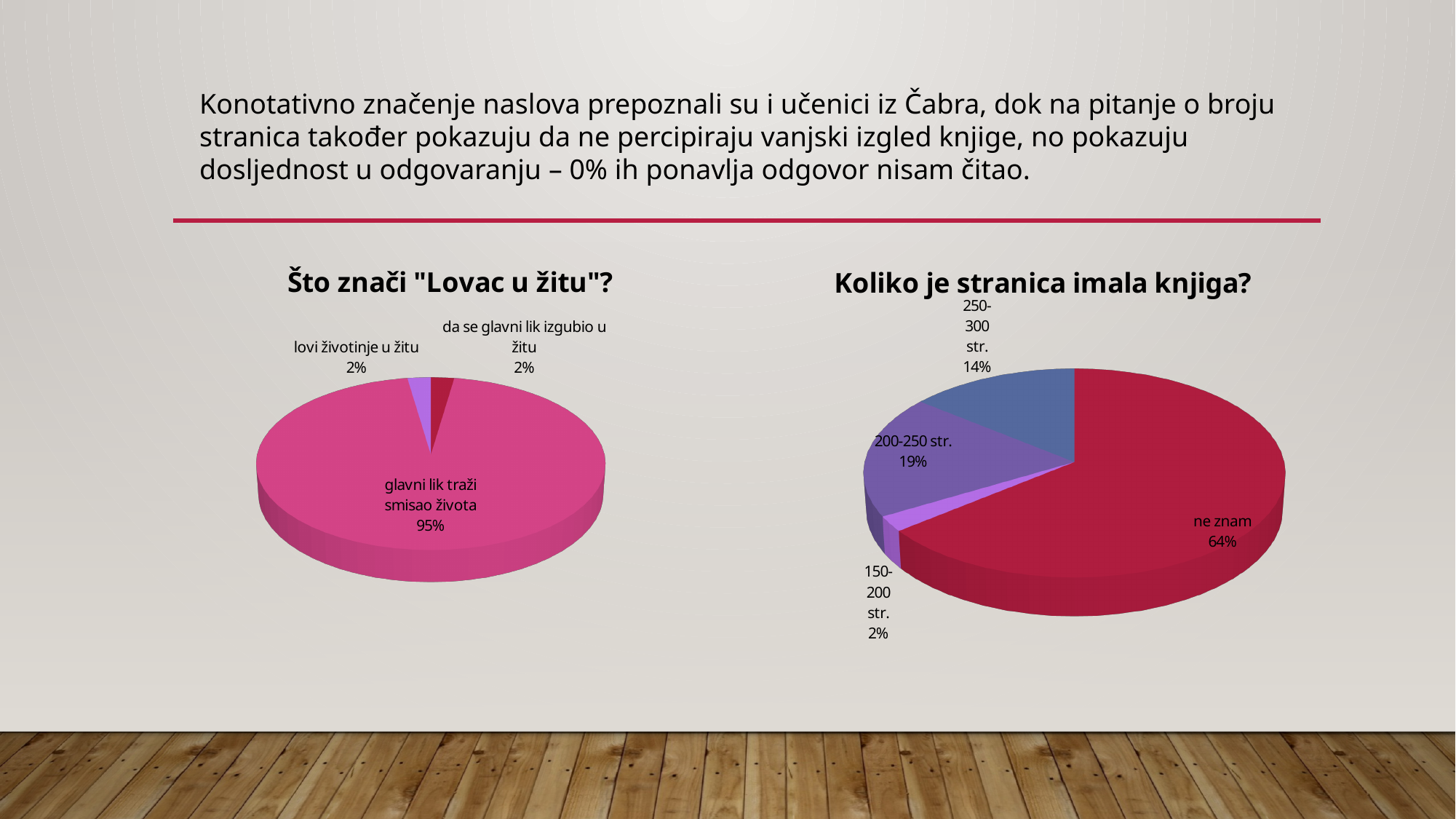
In the chart titled "Koliko je stranica imala knjiga?", what share is labelled for "250-300 str."? 14% In the chart titled "Koliko je stranica imala knjiga?", how many slices does the pie have? 4 In the chart titled "Što znači "Lovac u žitu"?", what share is labelled for "glavni lik traži smisao života"? 95% In the chart titled "Koliko je stranica imala knjiga?", what is the difference between the shares for "200-250 str." and "250-300 str."? 5% In the chart titled "Koliko je stranica imala knjiga?", which is larger, the share for "ne znam" or the share for "200-250 str."? ne znam In the chart titled "Što znači "Lovac u žitu"?", what share is labelled for "lovi životinje u žitu"? 2% In the chart titled "Koliko je stranica imala knjiga?", what share is labelled for "ne znam"? 64% In the chart titled "Koliko je stranica imala knjiga?", what share is labelled for "200-250 str."? 19% In the chart titled "Koliko je stranica imala knjiga?", which category has the smallest slice? 150-200 str. In the chart titled "Što znači "Lovac u žitu"?", which category has the largest slice? glavni lik traži smisao života What kind of chart is the chart titled "Što znači "Lovac u žitu"?"? pie chart In the chart titled "Što znači "Lovac u žitu"?", how many slices does the pie have? 3